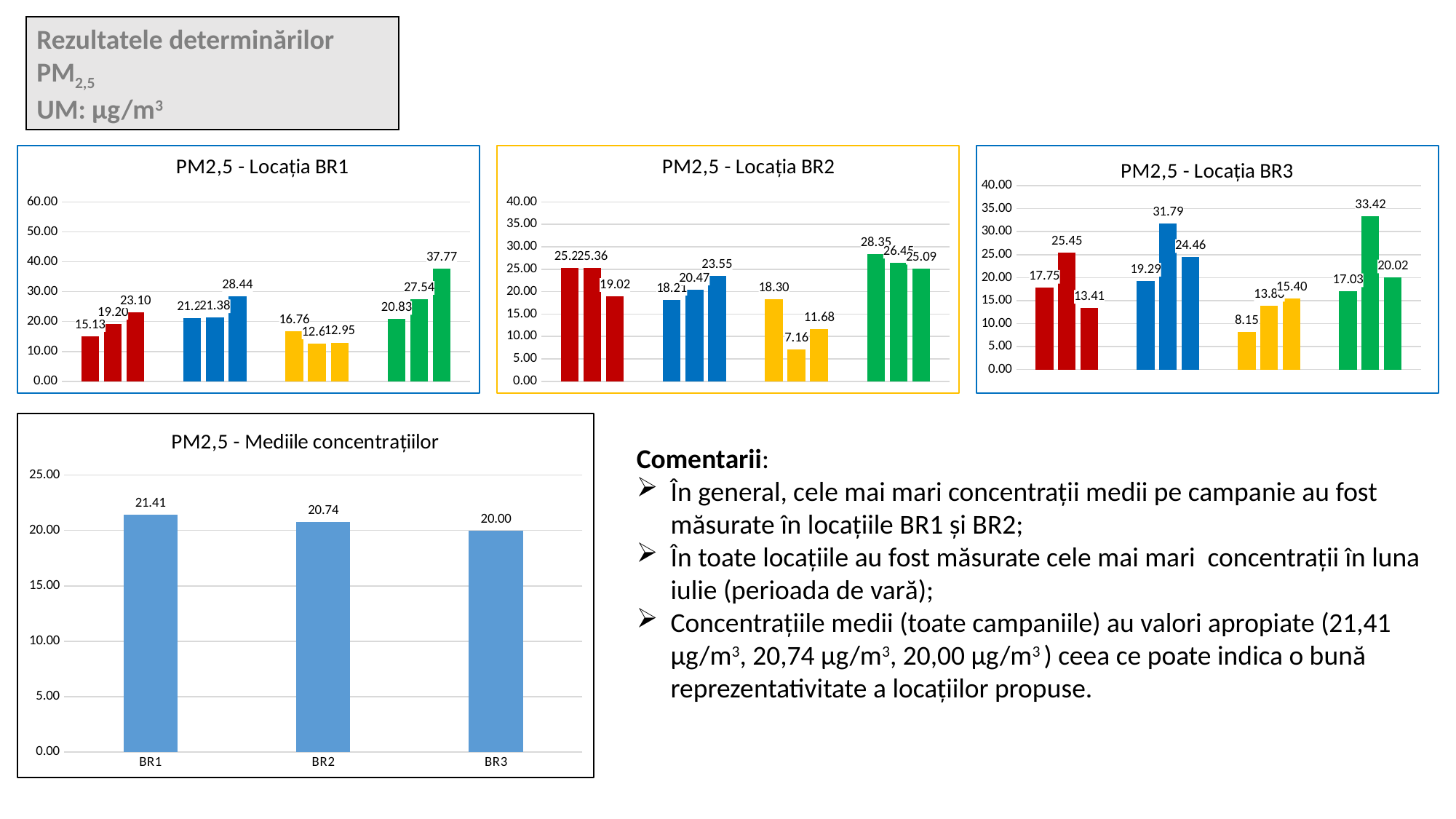
In the chart titled 'PM2,5 - Mediile concentrațiilor', which location has the highest value? BR1 What kind of chart is 'PM2,5 - Locația BR1'? bar chart In the chart titled 'PM2,5 - Mediile concentrațiilor', how many locations are shown on the x axis? 3 In the chart titled 'PM2,5 - Mediile concentrațiilor', what is the value for BR1? 21.41 In the chart titled 'PM2,5 - Mediile concentrațiilor', which is larger, the value for BR2 or the value for BR3? BR2 In the chart titled 'PM2,5 - Locația BR2', what is the lowest value shown? 7.16 In the chart titled 'PM2,5 - Locația BR3', what is the highest value shown? 33.42 In the chart titled 'PM2,5 - Mediile concentrațiilor', which location has the lowest value? BR3 In the chart titled 'PM2,5 - Locația BR1', what is the highest value shown? 37.77 In the chart titled 'PM2,5 - Mediile concentrațiilor', what is the value for BR3? 20.00 In the chart titled 'PM2,5 - Mediile concentrațiilor', what is the difference between the values for BR1 and BR3? 1.41 In the chart titled 'PM2,5 - Mediile concentrațiilor', do the values rise or fall from BR1 to BR3? fall